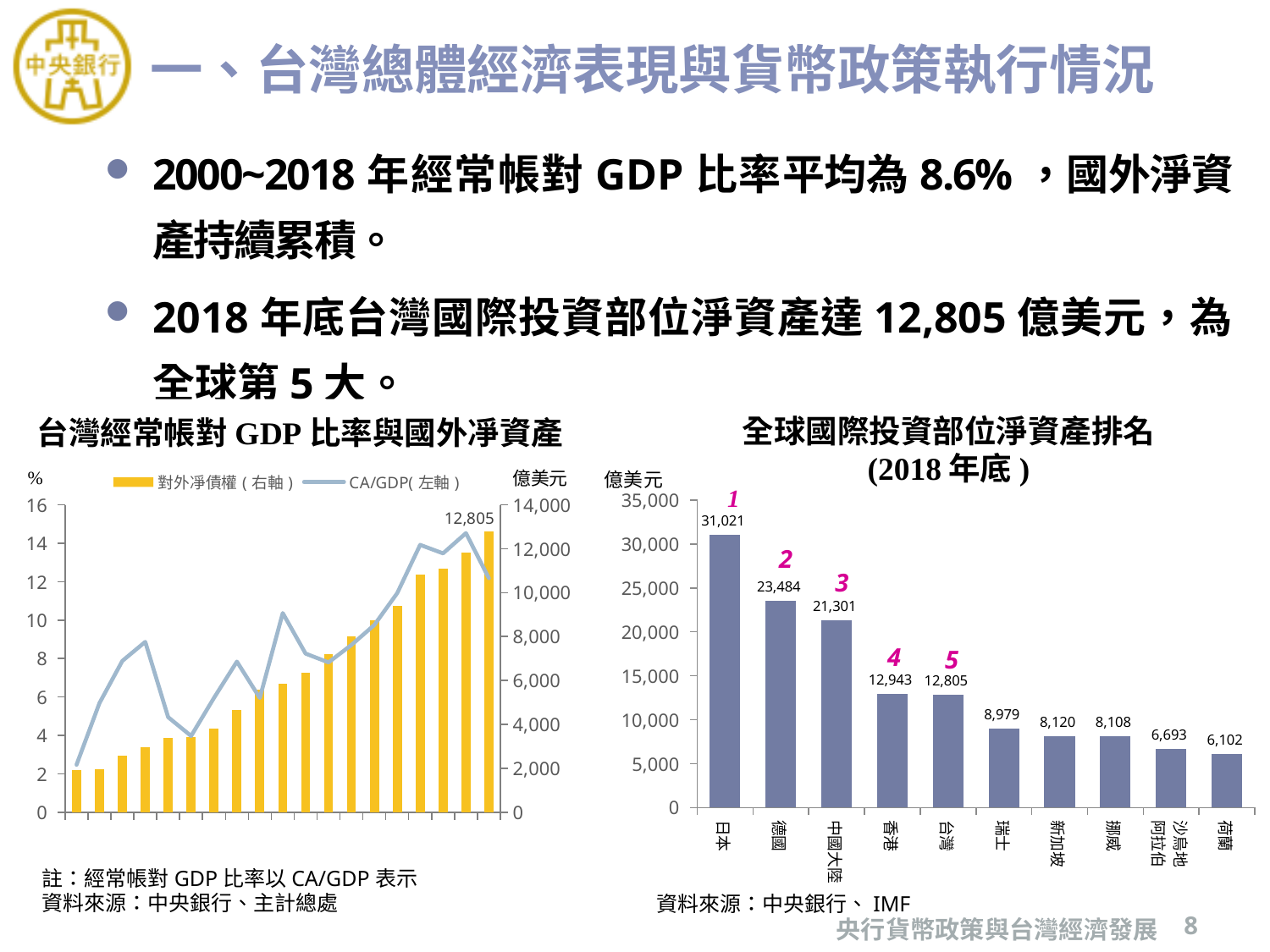
In the chart titled 全球國際投資部位淨資產排名 (2018年底), which is larger, the value for 新加坡 or 挪威? 新加坡 In the chart titled 台灣經常帳對GDP比率與國外淨資產, how many series does the legend list? 2 In the chart titled 全球國際投資部位淨資產排名 (2018年底), which country has the highest value? 日本 In the chart titled 全球國際投資部位淨資產排名 (2018年底), how many countries are shown? 10 What kind of chart is the one titled 全球國際投資部位淨資產排名 (2018年底)? bar chart In the chart titled 全球國際投資部位淨資產排名 (2018年底), what is the value for 日本? 31,021 In the chart titled 台灣經常帳對GDP比率與國外淨資產, do the 對外淨債權 bars generally rise or fall from left to right? rise In the chart titled 台灣經常帳對GDP比率與國外淨資產, what value is labelled on the last bar? 12,805 In the chart titled 全球國際投資部位淨資產排名 (2018年底), what is the difference between the values for 日本 and 德國? 7,537 In the chart titled 全球國際投資部位淨資產排名 (2018年底), what is the value for 台灣? 12,805 In the chart titled 全球國際投資部位淨資產排名 (2018年底), what is the difference between the values for 香港 and 台灣? 138 In the chart titled 全球國際投資部位淨資產排名 (2018年底), which country has the lowest value? 荷蘭